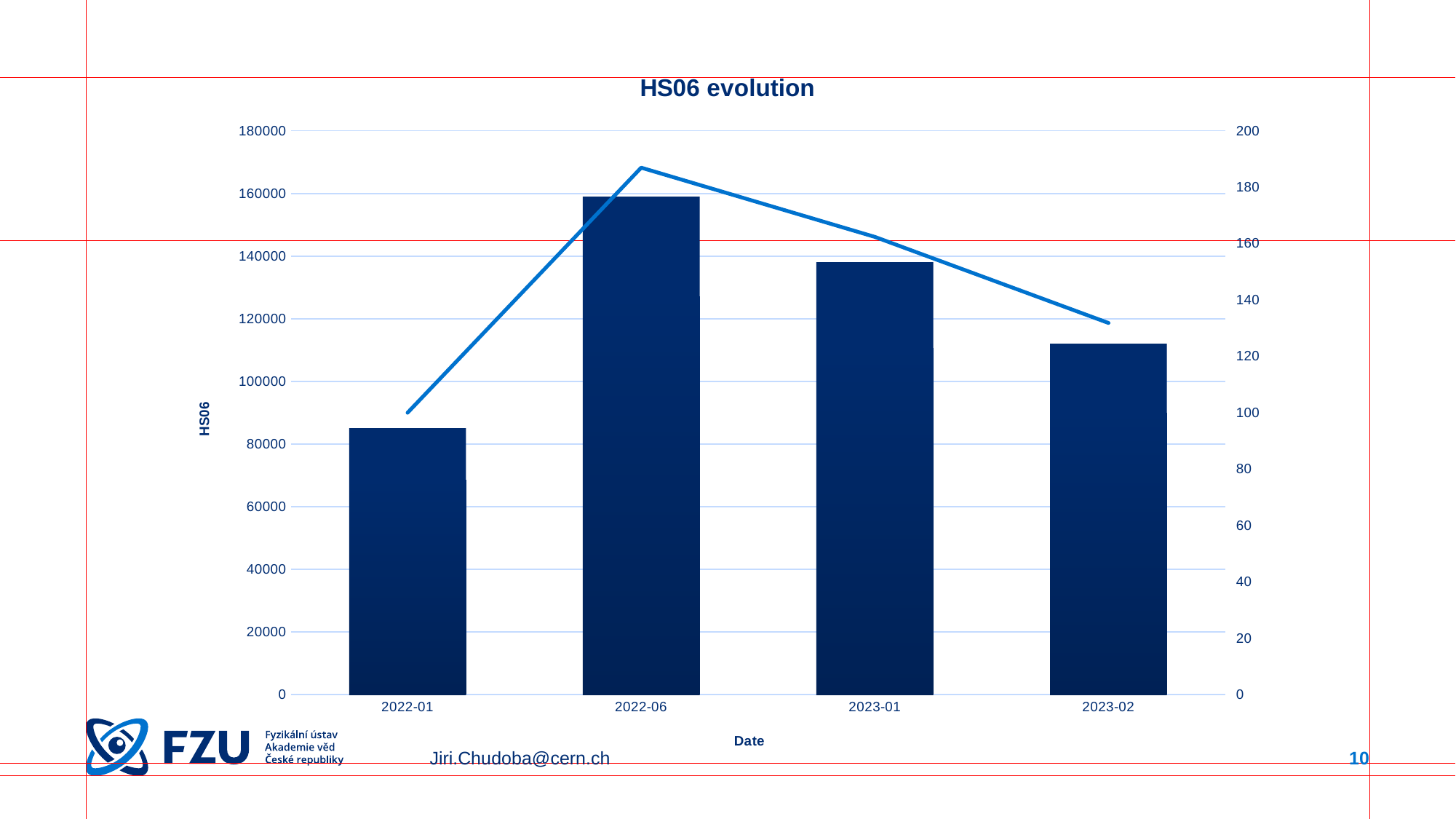
Which date has the tallest bar in the chart? 2022-06 How many dates are shown on the x axis of the chart? 4 Is the line value for 2022-01 greater or less than 120 on the right axis? less What kind of chart is shown on the slide? bar chart with a line Is the bar value for 2022-06 greater or less than 140000? greater Does the line series rise or fall between 2022-06 and 2023-02? fall Is the bar for 2023-01 taller or shorter than the bar for 2023-02? taller Is the bar value for 2023-02 greater or less than 100000? greater What is the title of the chart? HS06 evolution What is the label of the vertical axis on the left? HS06 Which date has the shortest bar in the chart? 2022-01